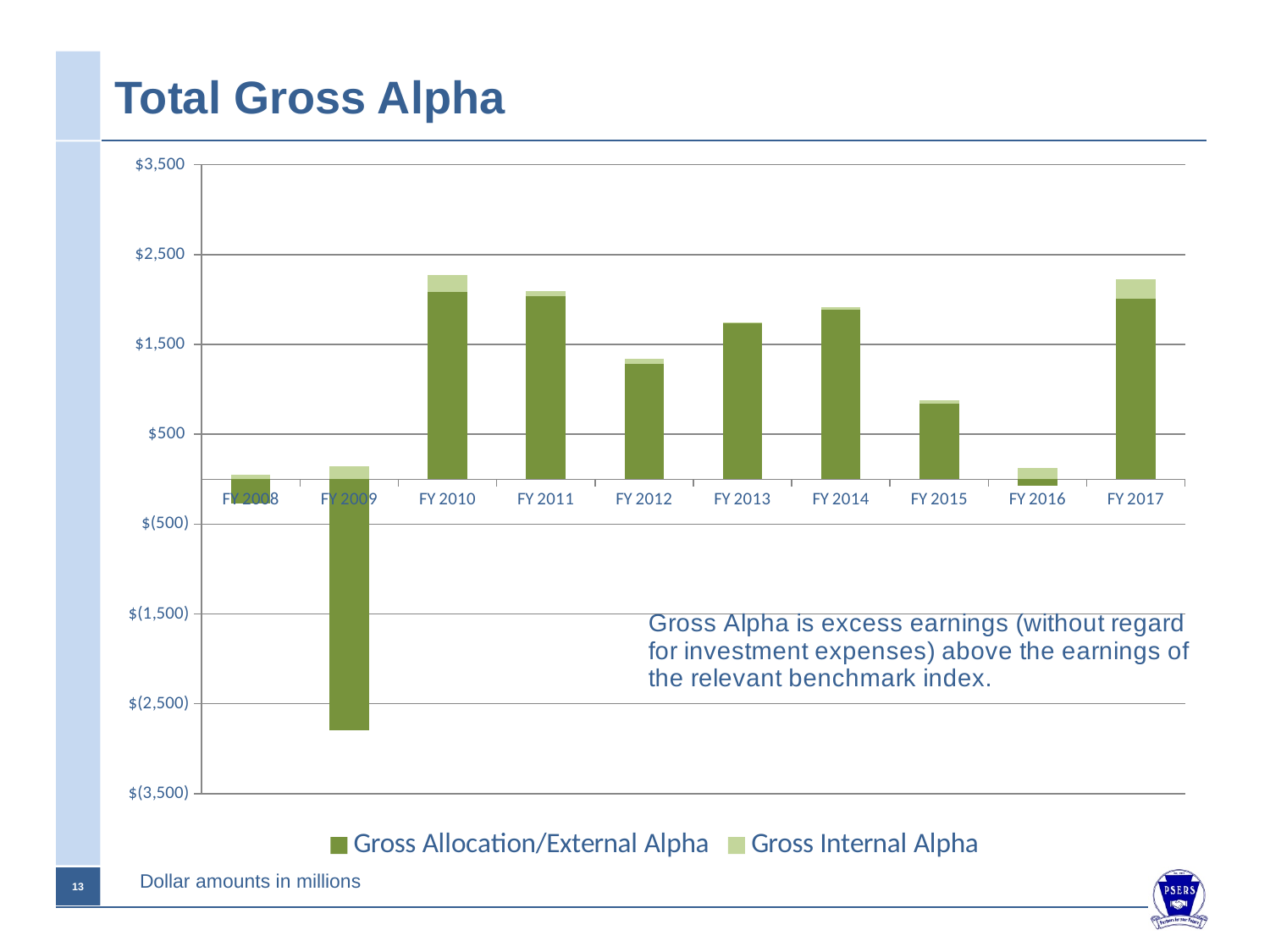
Do the Gross Allocation/External Alpha values rise or fall from FY 2010 to FY 2012? fall What kind of chart is shown on the slide? Bar chart How many series does the chart's legend list? 2 Which series is shown in the lighter green colour in the legend? Gross Internal Alpha Is the Gross Allocation/External Alpha value for FY 2010 greater or less than $1,500? greater What is the title of the chart? Total Gross Alpha How many fiscal years are shown on the x axis of the chart? 10 Which fiscal year has the lowest Gross Allocation/External Alpha value? FY 2009 Is the Gross Allocation/External Alpha value for FY 2009 greater or less than $(2,500)? less Is the Gross Allocation/External Alpha value for FY 2015 greater or less than $500? greater Which fiscal year has the larger Gross Allocation/External Alpha value, FY 2013 or FY 2015? FY 2013